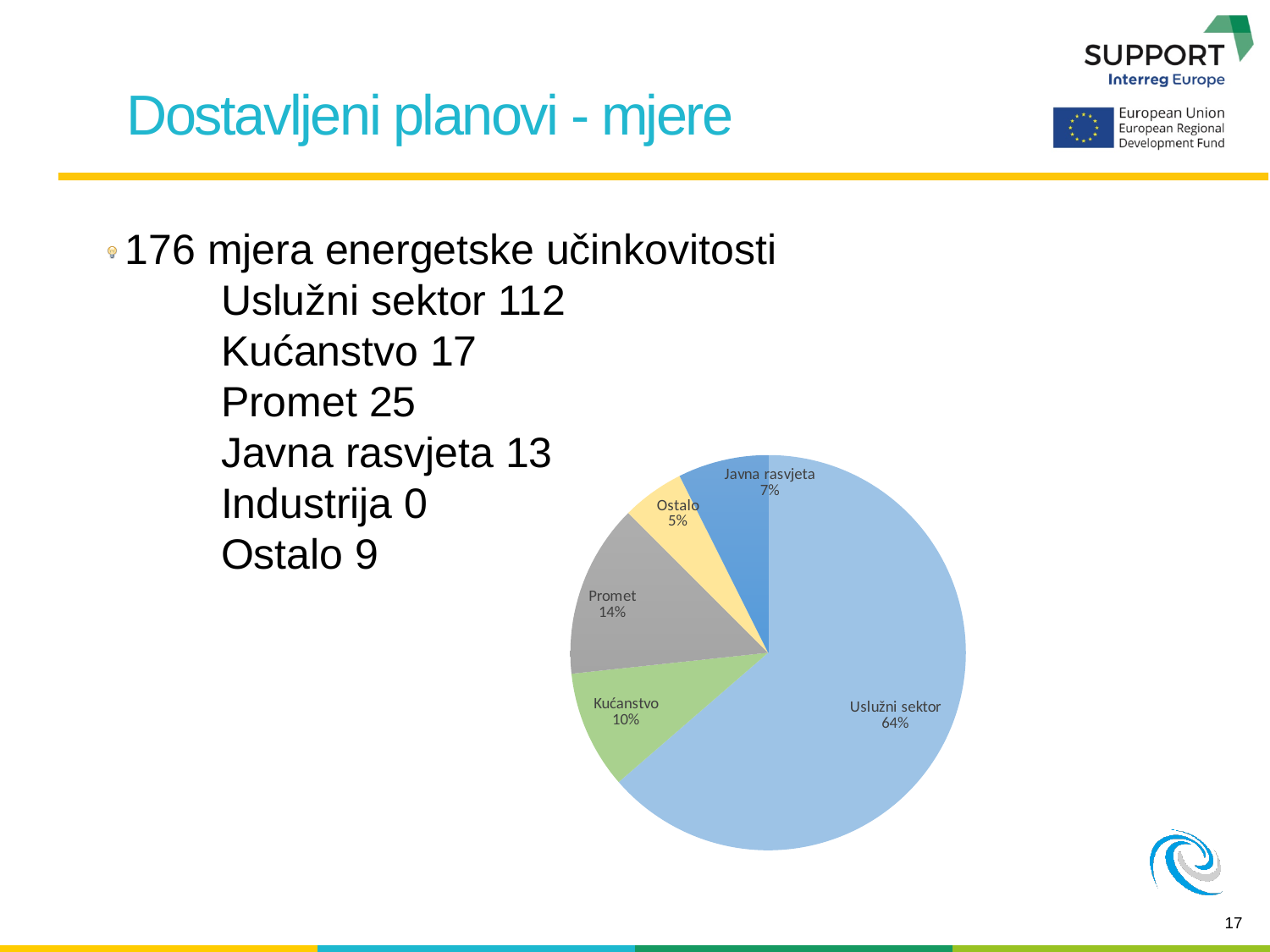
What share of the pie does Ostalo have? 5% Which slice is larger, Javna rasvjeta or Ostalo? Javna rasvjeta Which slice of the pie chart is the largest? Uslužni sektor Which slice of the pie chart is the smallest? Ostalo What share of the pie does Kućanstvo have? 10% What is the difference in percentage points between the Promet and Kućanstvo slices? 4 What kind of chart is shown on the slide? pie chart What share of the pie does Uslužni sektor have? 64% What colour is the Kućanstvo slice in the pie chart? green How many slices does the pie chart have? 5